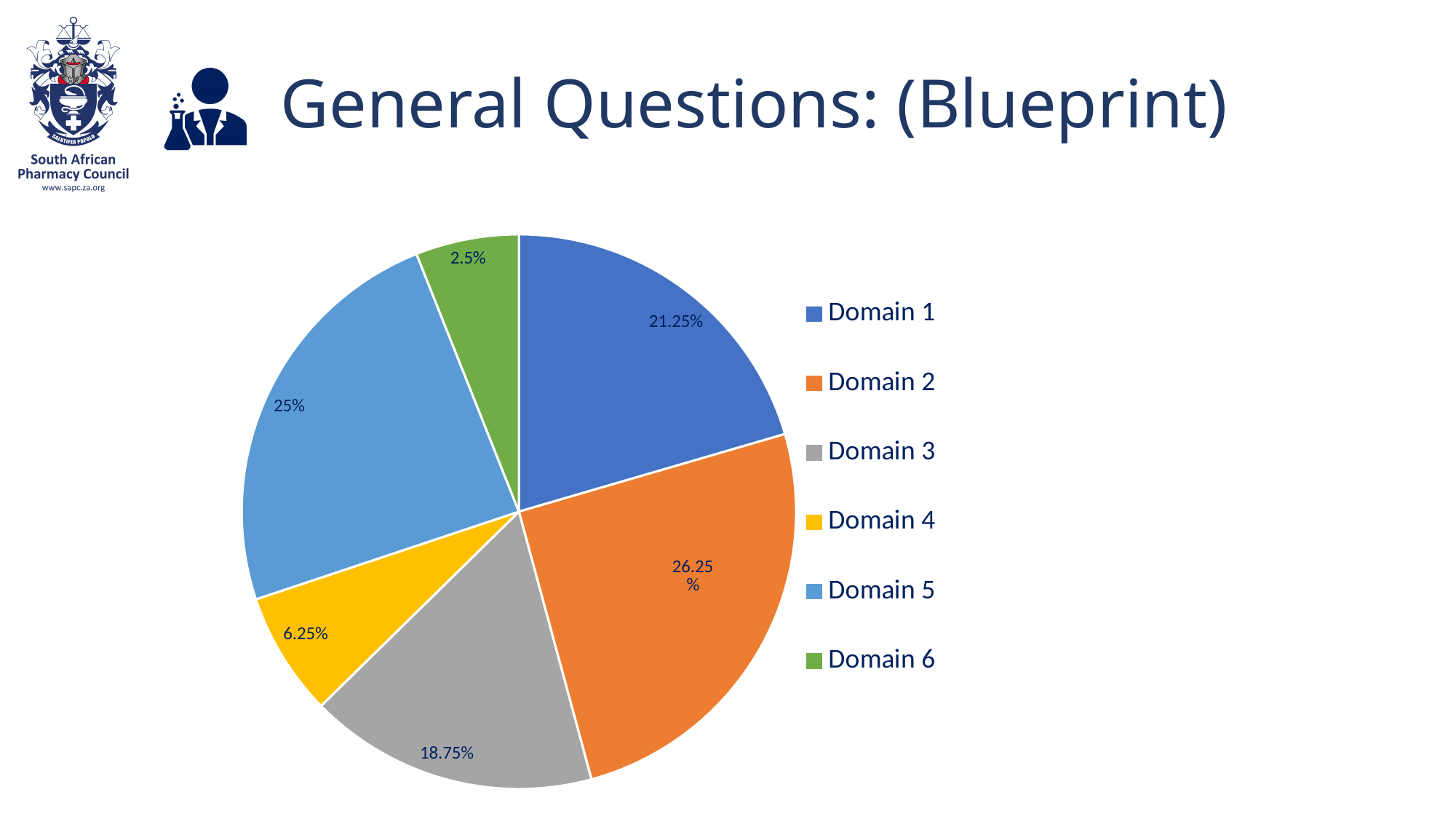
What percentage does Domain 4 account for? 6.25% What percentage does Domain 2 account for? 26.25% Which domain has the smallest share of the pie? Domain 6 Which is larger, the share for Domain 5 or the share for Domain 3? Domain 5 What percentage does Domain 5 account for? 25% What kind of chart is shown on the slide? pie chart What is the difference in percentage points between Domain 2 and Domain 1? 5 What percentage does Domain 3 account for? 18.75% What percentage does Domain 1 account for? 21.25% What percentage does Domain 6 account for? 2.5% How many domains are listed in the legend? 6 Which domain has the largest share of the pie? Domain 2